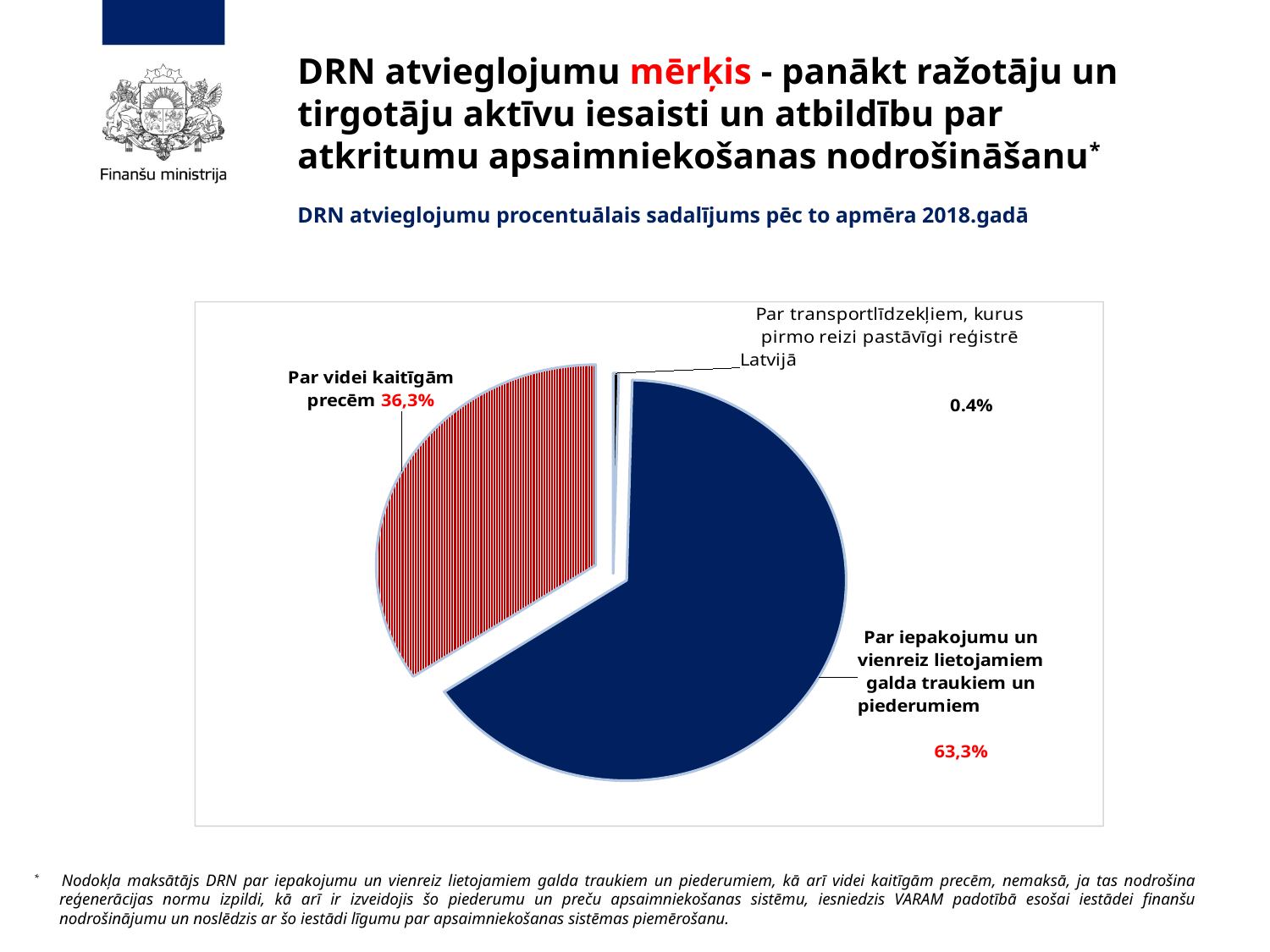
Which category has the smallest slice of the pie? Par transportlīdzekļiem, kurus pirmo reizi pastāvīgi reģistrē Latvijā What is the title of the pie chart? DRN atvieglojumu procentuālais sadalījums pēc to apmēra 2018.gadā What kind of chart is shown on the slide? pie chart What share of the pie does "Par iepakojumu un vienreiz lietojamiem galda traukiem un piederumiem" have? 63,3% Is the share for "Par videi kaitīgām precēm" greater or less than 50%? less Which is larger: the slice for "Par videi kaitīgām precēm" or the slice for "Par iepakojumu un vienreiz lietojamiem galda traukiem un piederumiem"? Par iepakojumu un vienreiz lietojamiem galda traukiem un piederumiem What is the difference in percentage points between the "Par iepakojumu un vienreiz lietojamiem galda traukiem un piederumiem" slice and the "Par videi kaitīgām precēm" slice? 27 percentage points How many slices does the pie chart have? 3 What share of the pie does "Par videi kaitīgām precēm" have? 36,3% Which category has the largest slice of the pie? Par iepakojumu un vienreiz lietojamiem galda traukiem un piederumiem Which year does the pie chart's title refer to? 2018 What share of the pie does "Par transportlīdzekļiem, kurus pirmo reizi pastāvīgi reģistrē Latvijā" have? 0.4%